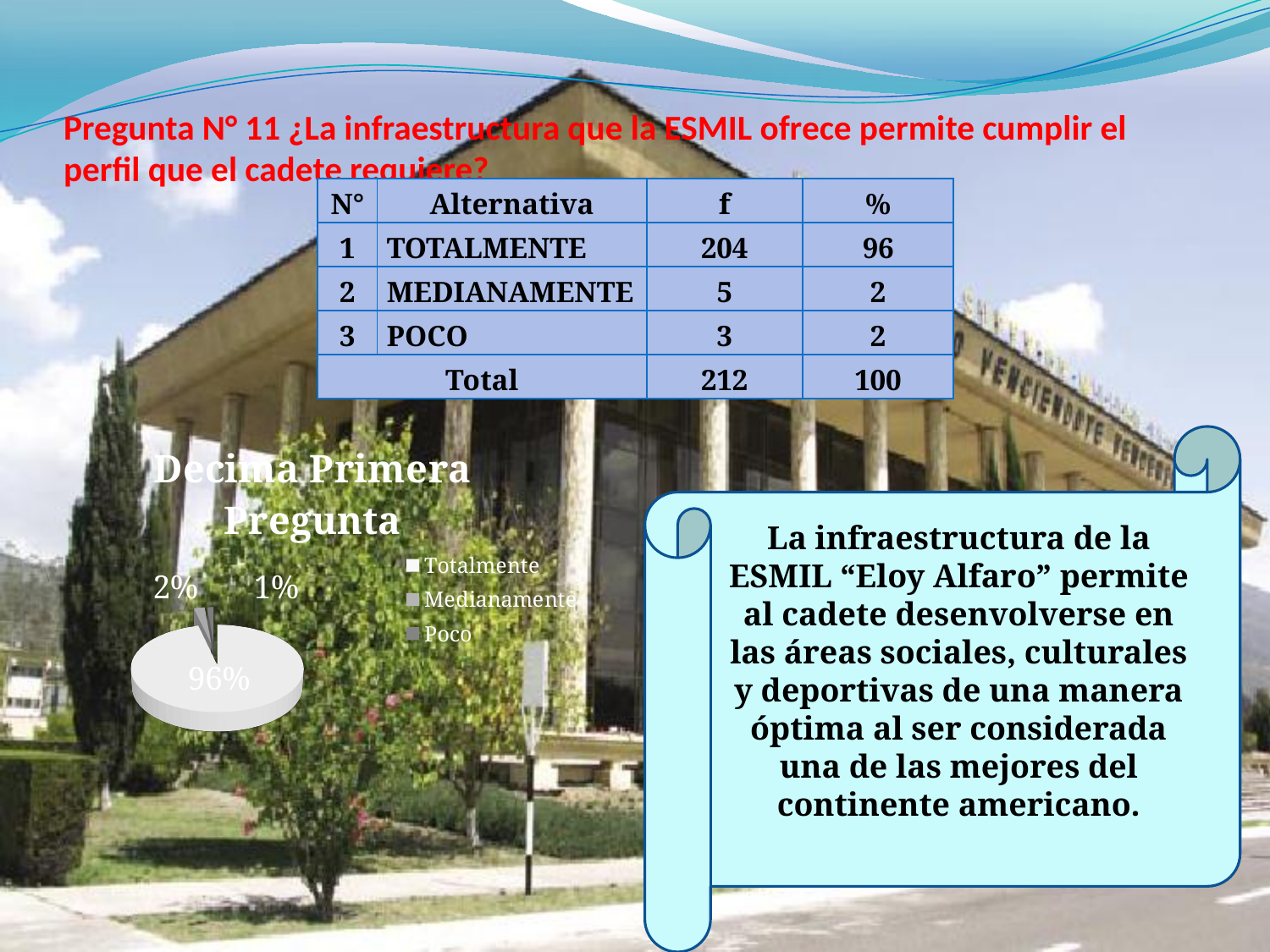
How many entries does the legend of the pie chart list? 3 How many slices does the pie chart have? 3 Which legend entry is listed first in the pie chart's legend? Totalmente What is the title of the pie chart? Decima Primera Pregunta What kind of chart is shown on the slide? pie chart Which category has the largest slice in the pie chart? Totalmente What is the difference between the Totalmente share and the Medianamente share in the pie chart? 94% Which category has the smallest slice in the pie chart? Poco What share of the pie does the Totalmente slice represent? 96% Which is larger in the pie chart, the Totalmente slice or the Medianamente slice? Totalmente What percentage is shown for Medianamente in the pie chart? 2% What percentage is shown for Poco in the pie chart? 1%